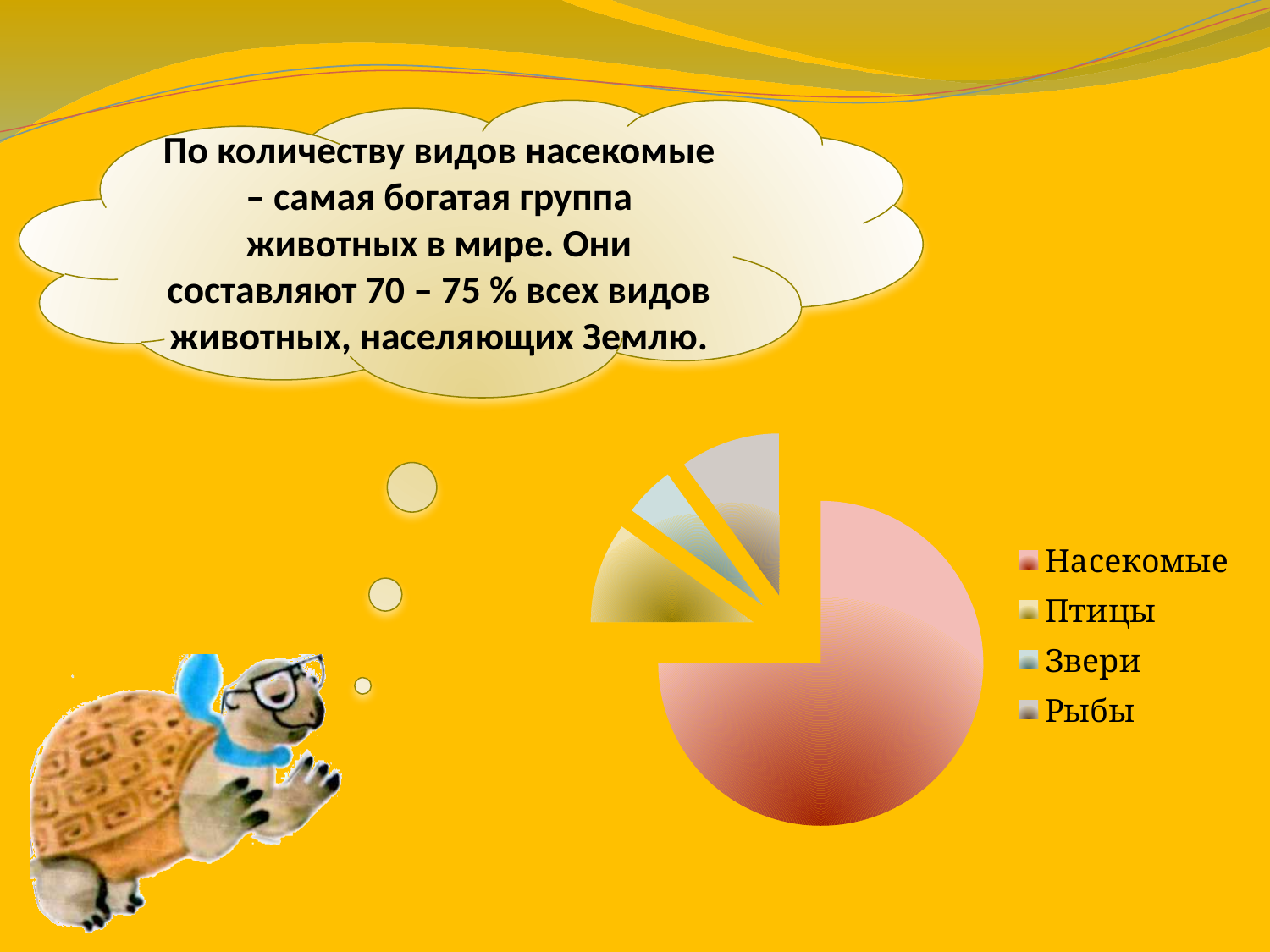
Which slice is larger, Насекомые or Птицы? Насекомые What are the legend entries of the pie chart, in order? Насекомые, Птицы, Звери, Рыбы What colour is the Насекомые slice in the pie chart? pink/red Which category has the largest slice of the pie chart? Насекомые What kind of chart is shown on the slide? pie chart How many categories does the pie chart have? 4 Which slice is larger, Птицы or Звери? Птицы